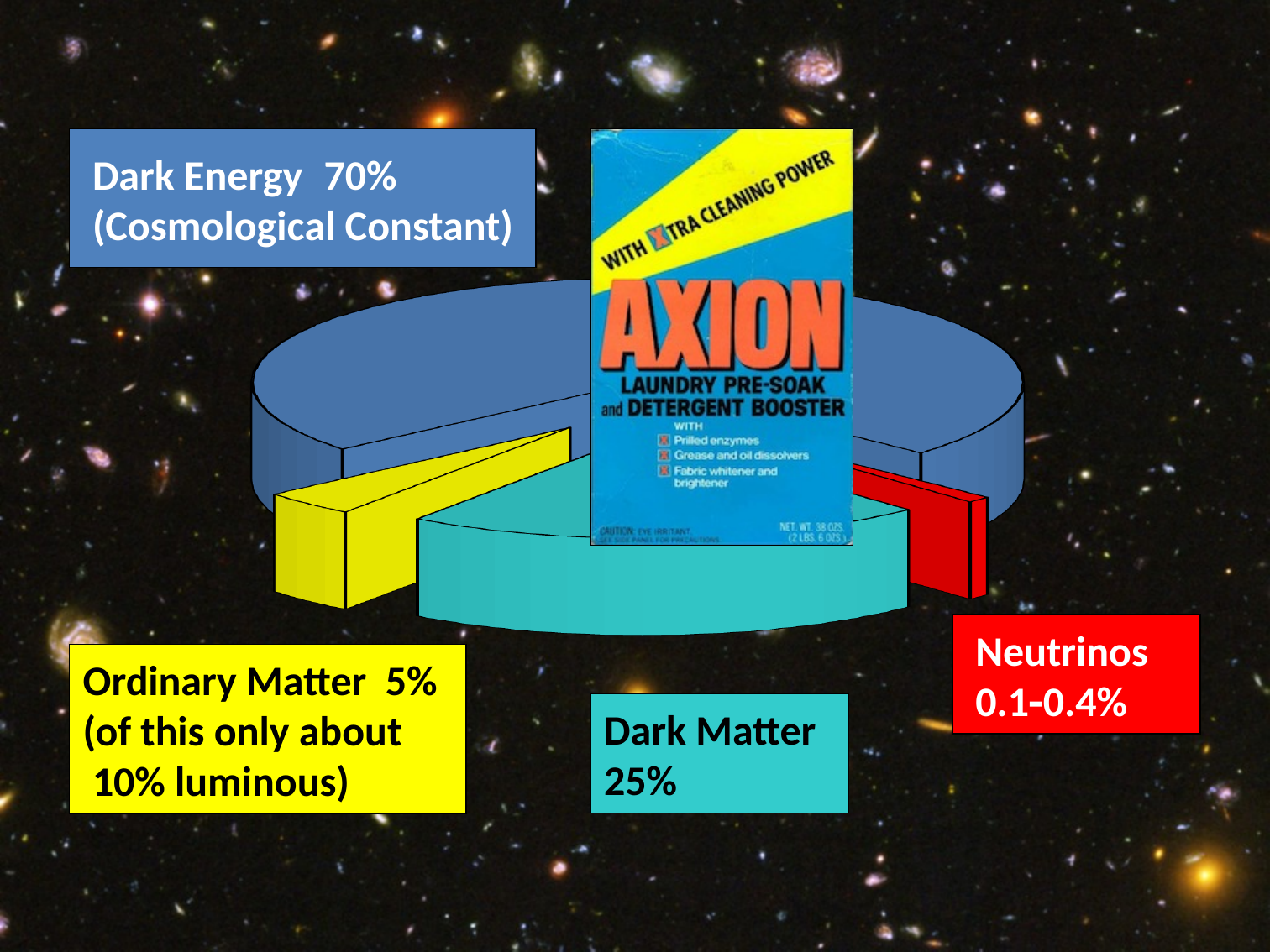
What colour is the Neutrinos slice? red What is the difference between the Dark Energy share and the Dark Matter share? 45% What share is labelled for Neutrinos? 0.1-0.4% What share of the pie is labelled for Dark Matter? 25% What share of the pie is labelled for Ordinary Matter? 5% What colour is the Dark Matter slice? cyan Which slice of the pie is the largest? Dark Energy What kind of chart is shown on the slide? pie chart Which is larger, the Dark Matter slice or the Ordinary Matter slice? Dark Matter What share of the pie is labelled for Dark Energy? 70% Which slice of the pie is the smallest? Neutrinos How many slices does the pie chart have? 4